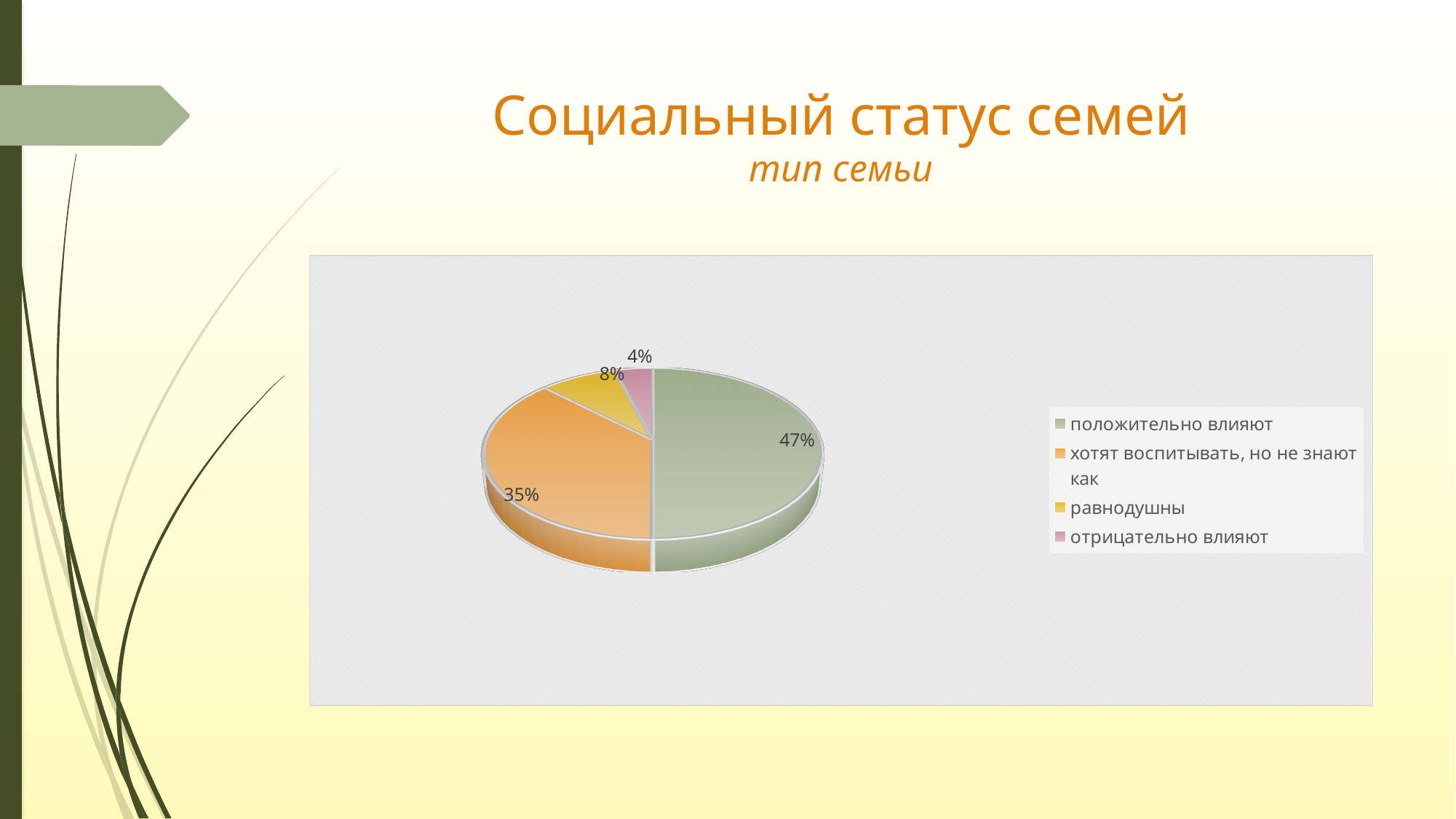
Which category has the smallest slice of the pie? отрицательно влияют What colour is the slice for "хотят воспитывать, но не знают как"? orange How many entries does the legend list? 4 Which is larger: the slice for "равнодушны" or the slice for "отрицательно влияют"? равнодушны Which category has the largest slice of the pie? положительно влияют What share of the pie is labelled "положительно влияют"? 47% How many slices does the pie chart have? 4 What share of the pie is labelled "хотят воспитывать, но не знают как"? 35% What kind of chart is shown on the slide? pie chart What share of the pie is labelled "отрицательно влияют"? 4% What share of the pie is labelled "равнодушны"? 8% What is the difference in percentage points between "положительно влияют" and "хотят воспитывать, но не знают как"? 12